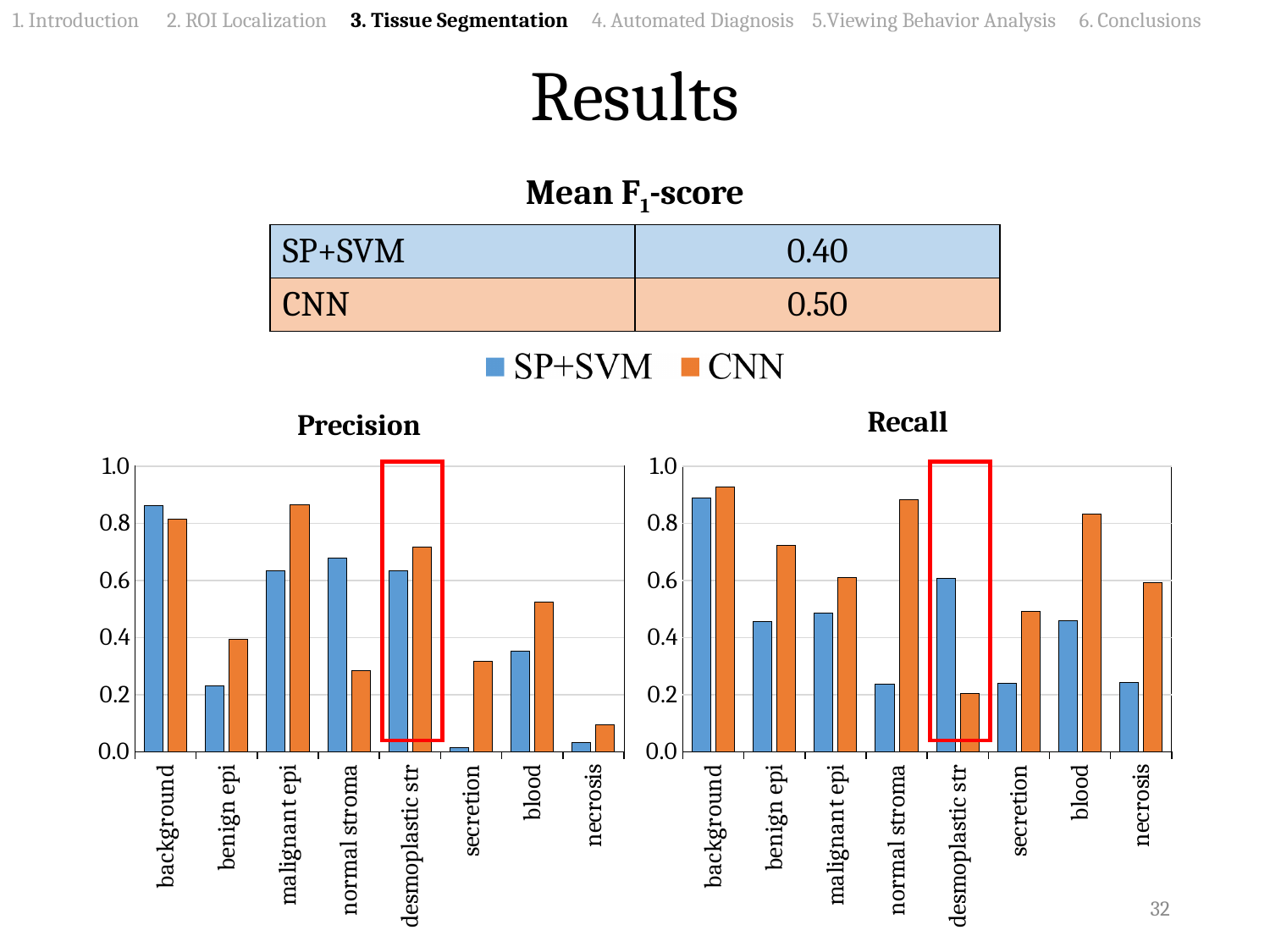
What kind of chart is the Precision chart? bar chart In the Precision chart, which category has the highest SP+SVM value? background In the Recall chart, which category has the highest SP+SVM value? background In the Precision chart, is the CNN value for secretion greater or less than 0.4? less How many series does the legend list for the Precision and Recall charts? 2 Which category is highlighted with a red box in both the Precision and Recall charts? desmoplastic str In the Precision chart, which is larger for normal stroma, SP+SVM or CNN? SP+SVM How many tissue categories are shown on the x axis of the Recall chart? 8 In the Recall chart, is the CNN value for normal stroma greater or less than 0.8? greater In the Recall chart, which category has the lowest CNN value? desmoplastic str In the Recall chart, which is larger for desmoplastic str, SP+SVM or CNN? SP+SVM In the Precision chart, which category has the lowest CNN value? necrosis